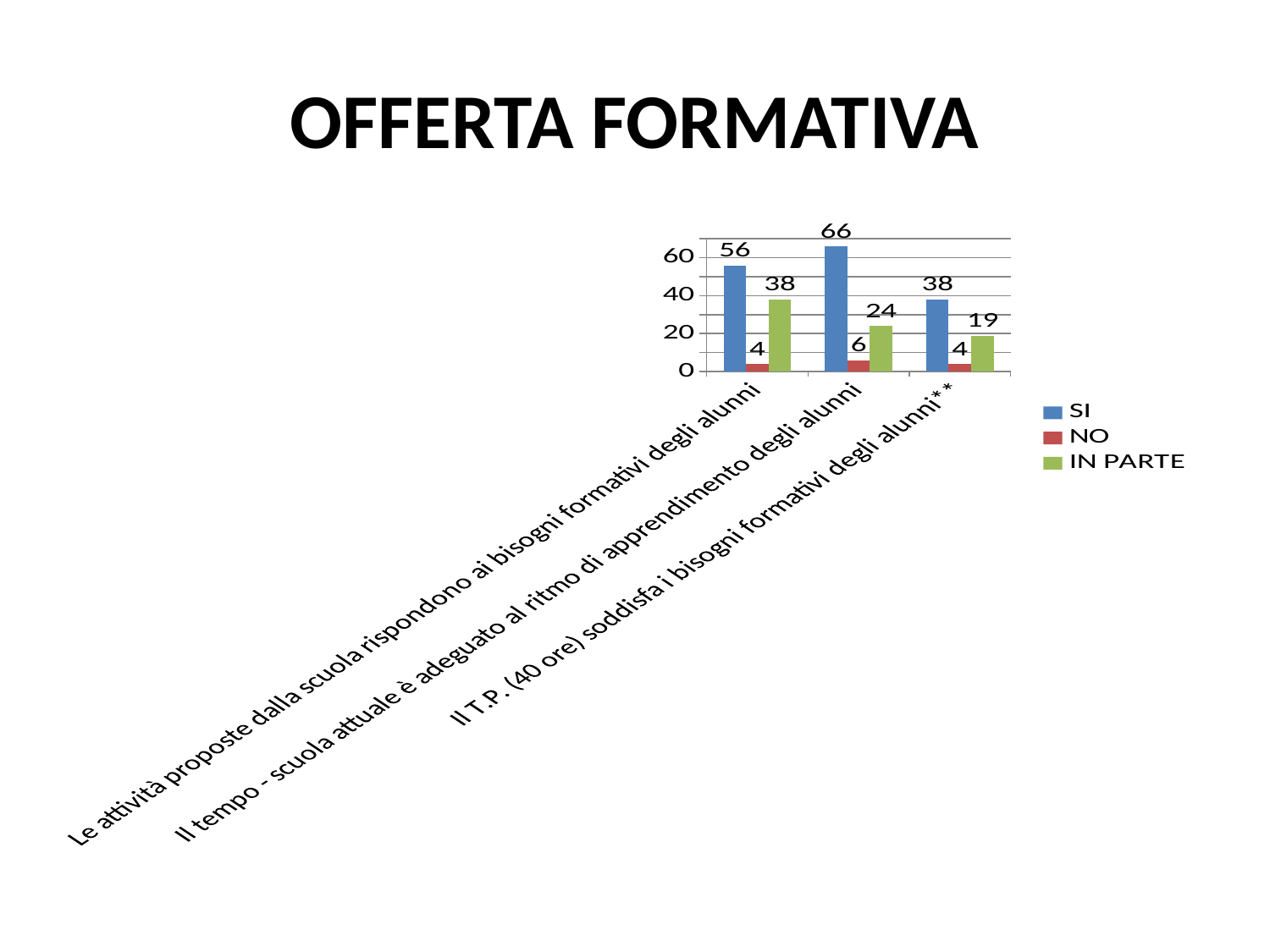
How many series does the legend list? 3 Is the SI value for "Le attività proposte dalla scuola rispondono ai bisogni formativi degli alunni" greater or less than 40? greater What is the difference between the SI and IN PARTE values for "Il tempo - scuola attuale è adeguato al ritmo di apprendimento degli alunni"? 42 How many categories are shown on the x axis? 3 What kind of chart is shown on the slide? bar chart Which category has the highest SI value? Il tempo - scuola attuale è adeguato al ritmo di apprendimento degli alunni Which is larger for "Il T.P. (40 ore) soddisfa i bisogni formativi degli alunni**": the SI value or the IN PARTE value? SI What is the IN PARTE value for "Il tempo - scuola attuale è adeguato al ritmo di apprendimento degli alunni"? 24 What is the SI value for "Le attività proposte dalla scuola rispondono ai bisogni formativi degli alunni"? 56 Which category has the lowest IN PARTE value? Il T.P. (40 ore) soddisfa i bisogni formativi degli alunni** What is the title of the slide? OFFERTA FORMATIVA What is the NO value for "Il T.P. (40 ore) soddisfa i bisogni formativi degli alunni**"? 4